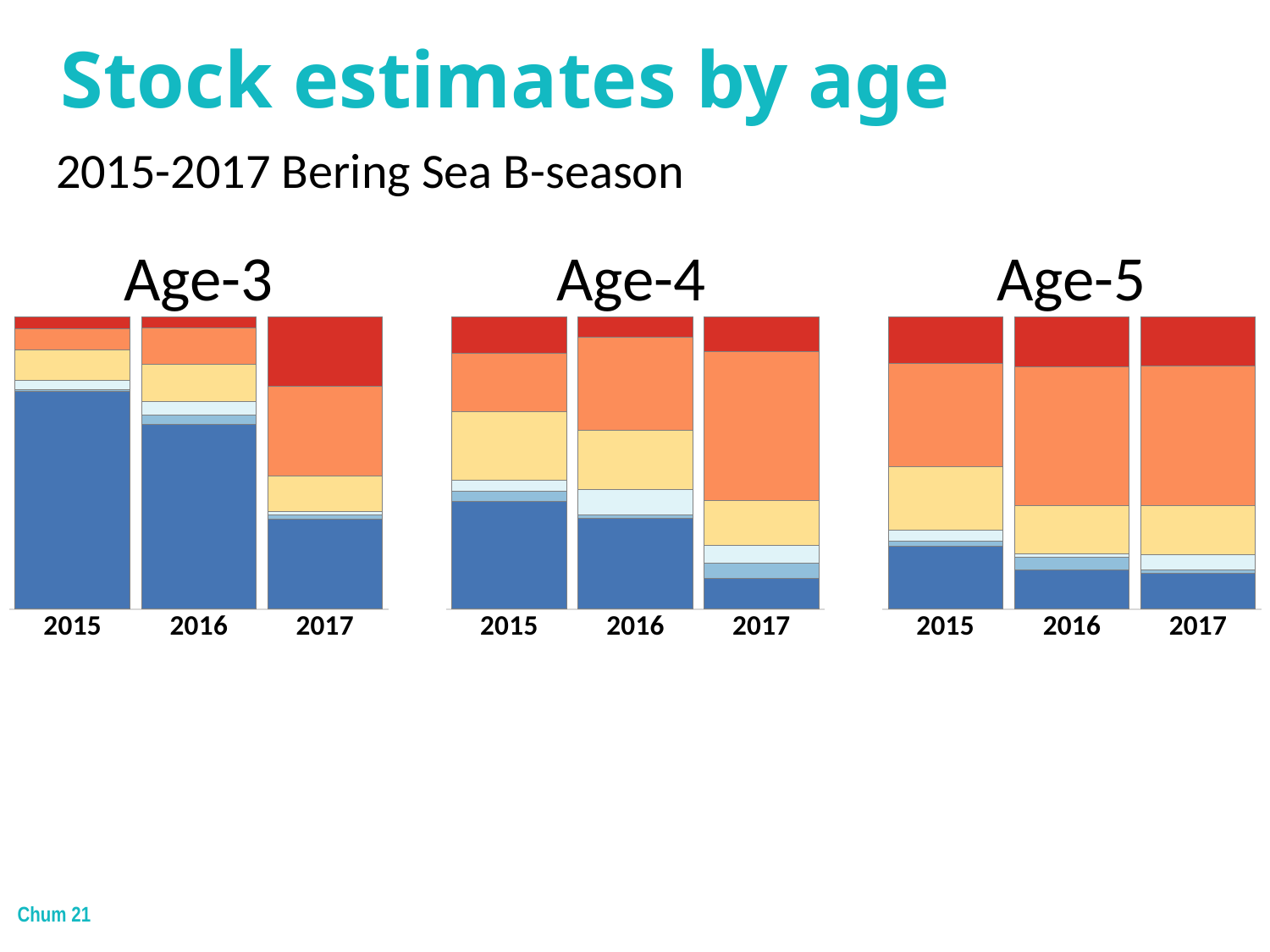
In the Age-3 chart, does the dark blue bottom segment grow or shrink from 2015 to 2017? Shrink In the Age-4 chart, does the dark blue bottom segment grow or shrink from 2015 to 2017? Shrink In the Age-5 chart, which year has the largest dark blue bottom segment? 2015 What is the subtitle shown above the charts? 2015-2017 Bering Sea B-season What are the titles of the three charts on the slide? Age-3, Age-4, Age-5 In the Age-4 chart, is the orange segment larger in 2015 or in 2017? 2017 How many charts are shown on the slide? 3 How many years (categories) are plotted in the Age-4 chart? 3 In the Age-3 chart, is the dark blue bottom segment larger in 2015 or in 2017? 2015 What kind of chart is used for the Age-3, Age-4 and Age-5 panels? Stacked bar chart In the Age-3 chart, which year has the largest dark red top segment? 2017 In the Age-5 chart, is the yellow segment larger in 2015 or in 2017? 2015